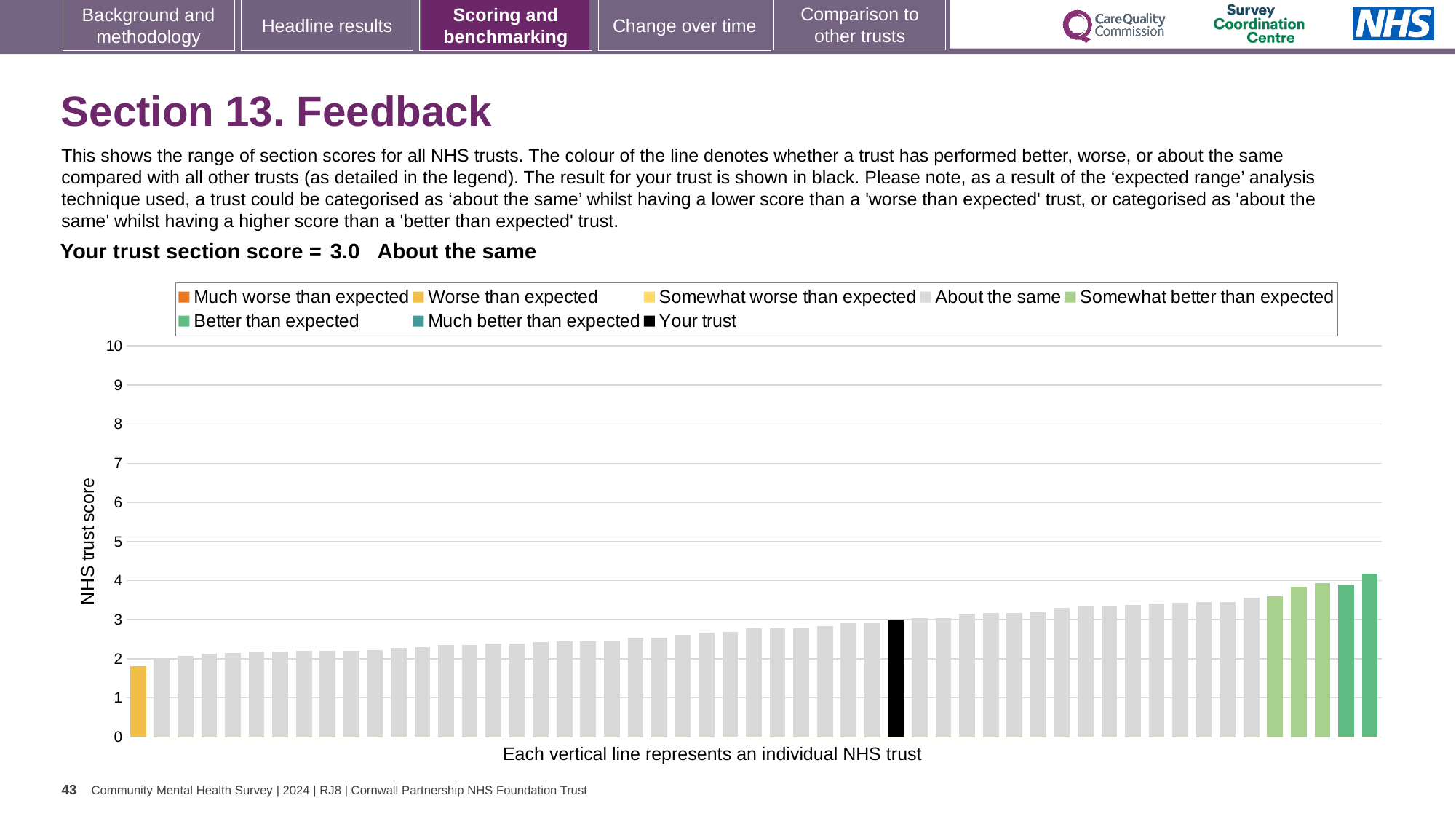
What is the section score for your trust shown on the slide? 3.0 Is the value of the highest bar on the chart greater or less than 3? greater Is the value of the black bar (your trust) greater or less than 4? less What kind of chart is shown on the slide? bar chart Is the value of the black bar (your trust) greater or less than 2? greater What is the title of the y axis? NHS trust score How is your trust's section score categorised compared with other trusts? About the same How many entries does the chart legend list? 8 Do the bar values rise or fall from left to right along the x axis? rise What colour is the bar representing your trust? black